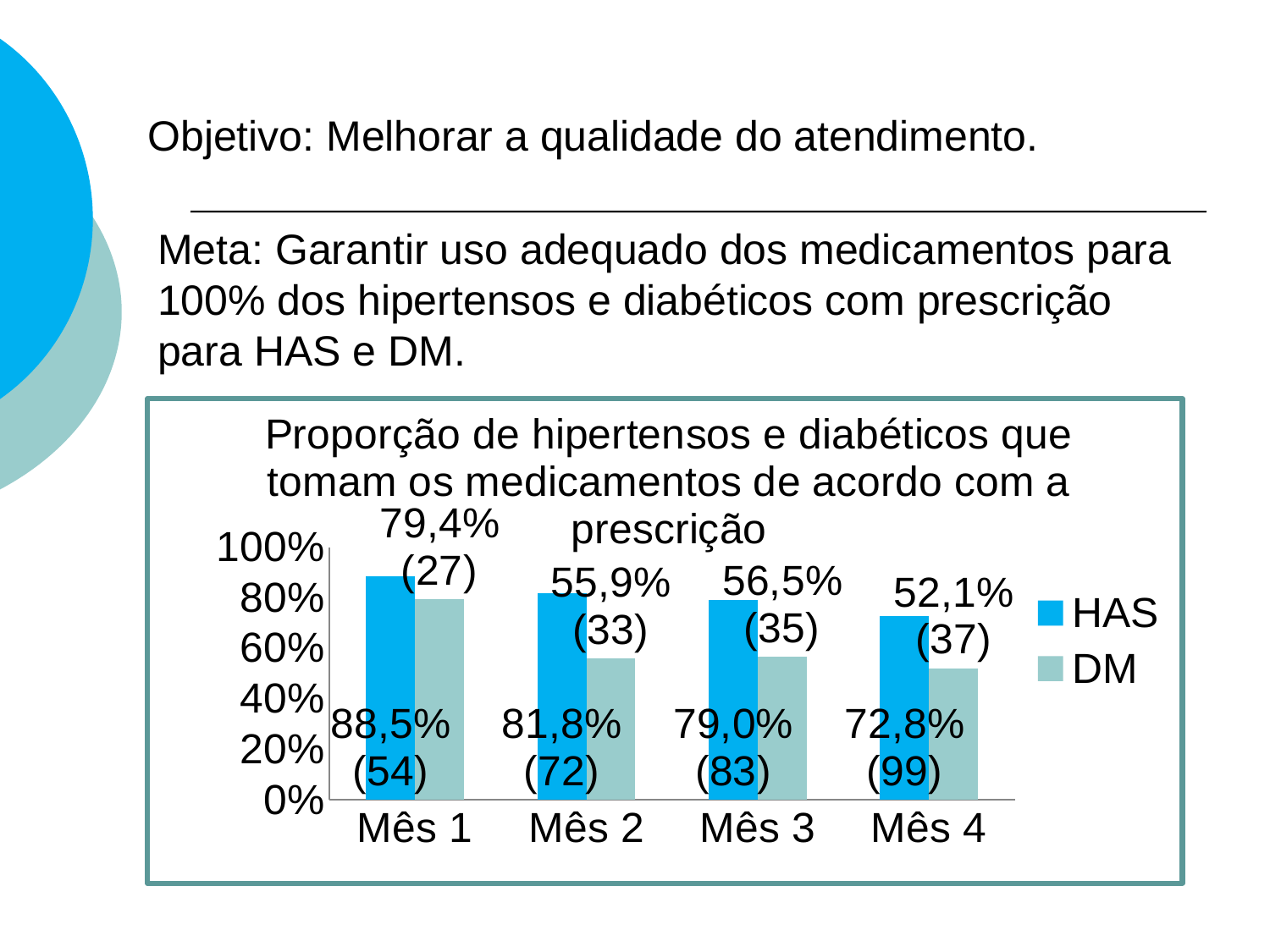
What is the DM value for Mês 4? 52,1% What is the HAS value for Mês 3? 79,0% In which month is the HAS value lowest? Mês 4 How many months are shown on the x axis? 4 How many series does the legend list? 2 What type of chart is shown on the slide? Bar chart In which month is the DM value highest? Mês 1 Which is larger in Mês 2, the HAS value or the DM value? HAS Do the HAS values rise or fall from Mês 1 to Mês 4? Fall What is the HAS value for Mês 1? 88,5% What is the DM value for Mês 2? 55,9% What is the difference between the HAS and DM values in Mês 1? 9,1 percentage points